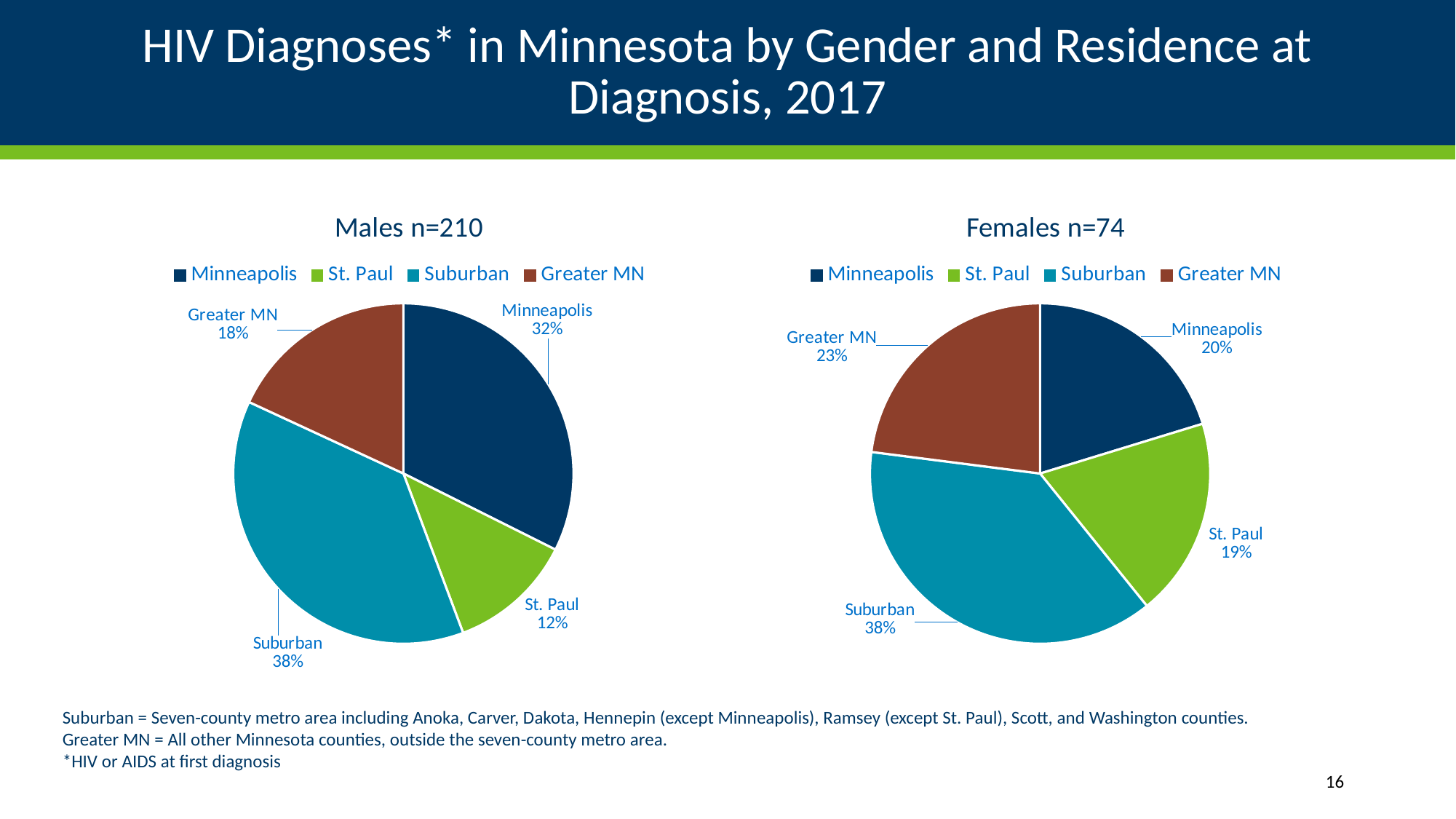
Which chart shows a larger share for Minneapolis, Males n=210 or Females n=74? Males n=210 In the Males n=210 pie chart, what is the difference in percentage points between Suburban and Minneapolis? 6 In the Females n=74 pie chart, what share of diagnoses is Greater MN? 23% In the Males n=210 pie chart, what share of diagnoses is Minneapolis? 32% How many categories does the Females n=74 pie chart have? 4 In the Males n=210 pie chart, which residence category has the largest share? Suburban In the Males n=210 pie chart, which is larger, Greater MN or St. Paul? Greater MN In the Males n=210 pie chart, what colour is the Suburban slice? Teal In the Females n=74 pie chart, what is the difference in percentage points between Greater MN and St. Paul? 4 In the Males n=210 pie chart, which residence category has the smallest share? St. Paul What type of chart is used for Males n=210? Pie chart In the Females n=74 pie chart, which residence category has the largest share? Suburban